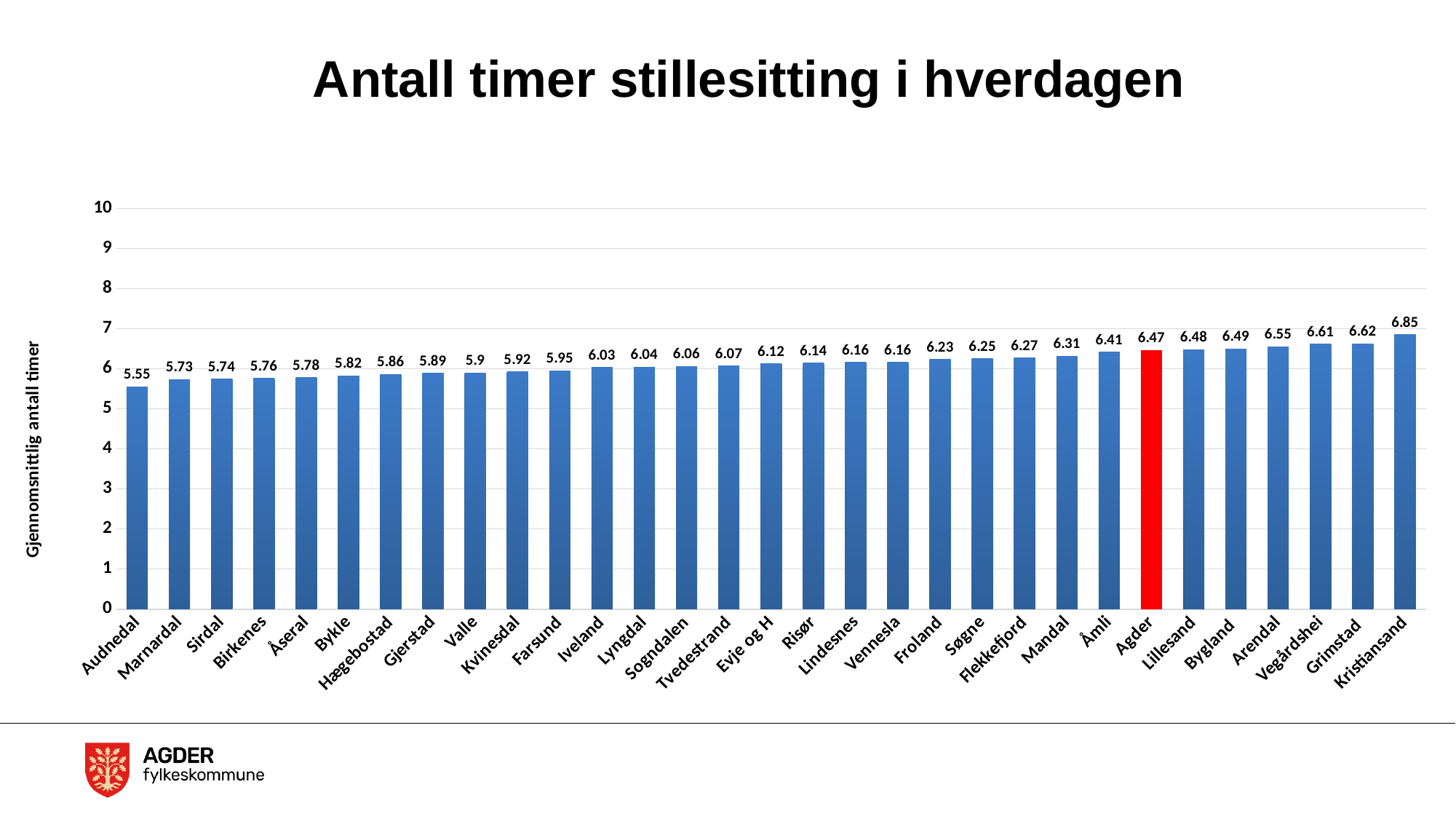
What kind of chart is shown on the slide? Bar chart What is the value for Agder? 6.47 What is the difference between the values for Agder and Mandal? 0.16 How many categories are shown on the x axis? 31 Which category has the highest value? Kristiansand What is the value for Flekkefjord? 6.27 What is the difference between the values for Kristiansand and Audnedal? 1.3 Which category has the lowest value? Audnedal What is the value for Kristiansand? 6.85 Which bar is coloured red instead of blue? Agder Which is larger, the value for Grimstad or the value for Froland? Grimstad What is the value for Audnedal? 5.55